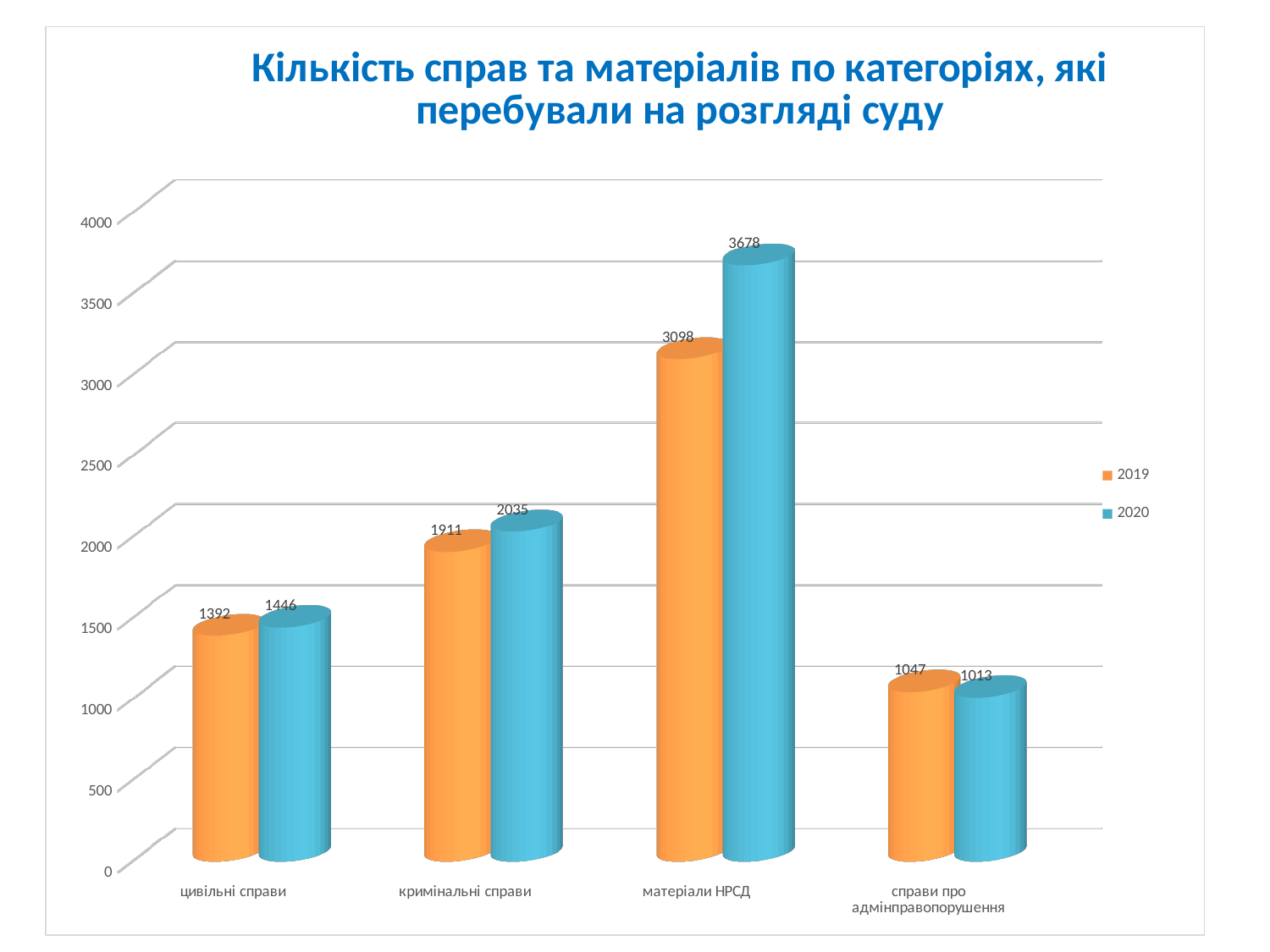
What is the difference between the 2020 and 2019 values for 'матеріали НРСД'? 580 How many series does the legend list? 2 What is the value for 2020 in the category 'кримінальні справи'? 2035 Which category has the highest value for 2020? матеріали НРСД What is the value for 2019 in the category 'справи про адмінправопорушення'? 1047 How many categories are shown on the x axis? 4 Which is larger for 'справи про адмінправопорушення': the 2019 value or the 2020 value? 2019 What kind of chart is shown on the slide? bar chart What is the value for 2019 in the category 'цивільні справи'? 1392 Which category has the lowest value for 2019? справи про адмінправопорушення Which colour represents the 2020 series? blue What is the value for 2020 in the category 'матеріали НРСД'? 3678